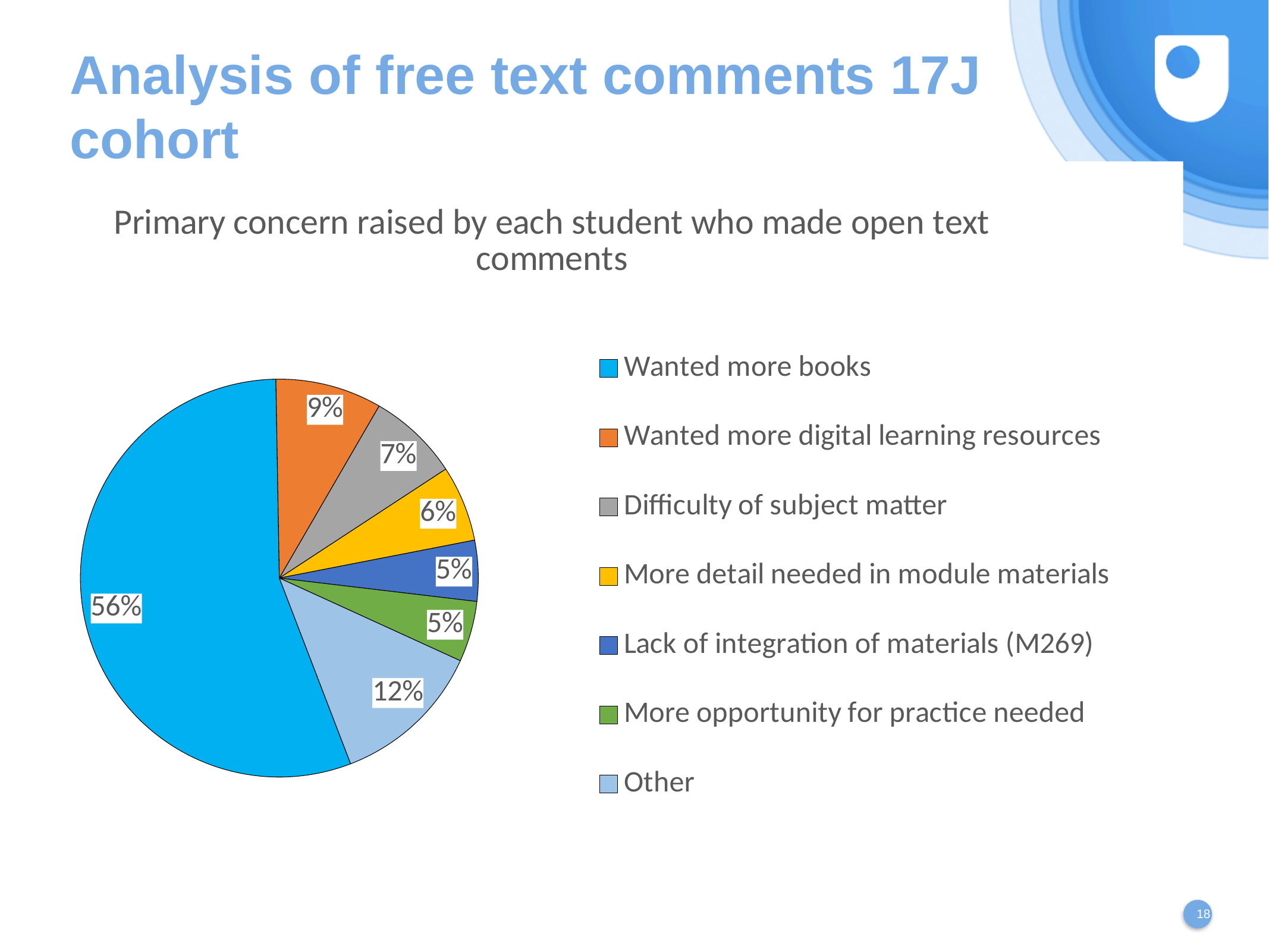
What share of the pie is 'Wanted more books'? 56% What share of the pie is 'More detail needed in module materials'? 6% How many categories does the pie chart have? 7 Which category is shown in orange in the legend? Wanted more digital learning resources What share of the pie is 'Other'? 12% What share of the pie is 'Difficulty of subject matter'? 7% What share of the pie is 'Wanted more digital learning resources'? 9% What is the difference between the shares for 'Wanted more books' and 'Other'? 44% Which is larger, the share for 'Wanted more digital learning resources' or the share for 'Difficulty of subject matter'? Wanted more digital learning resources Which category has the largest share of the pie? Wanted more books What is the chart's title? Primary concern raised by each student who made open text comments What type of chart is shown on the slide? Pie chart